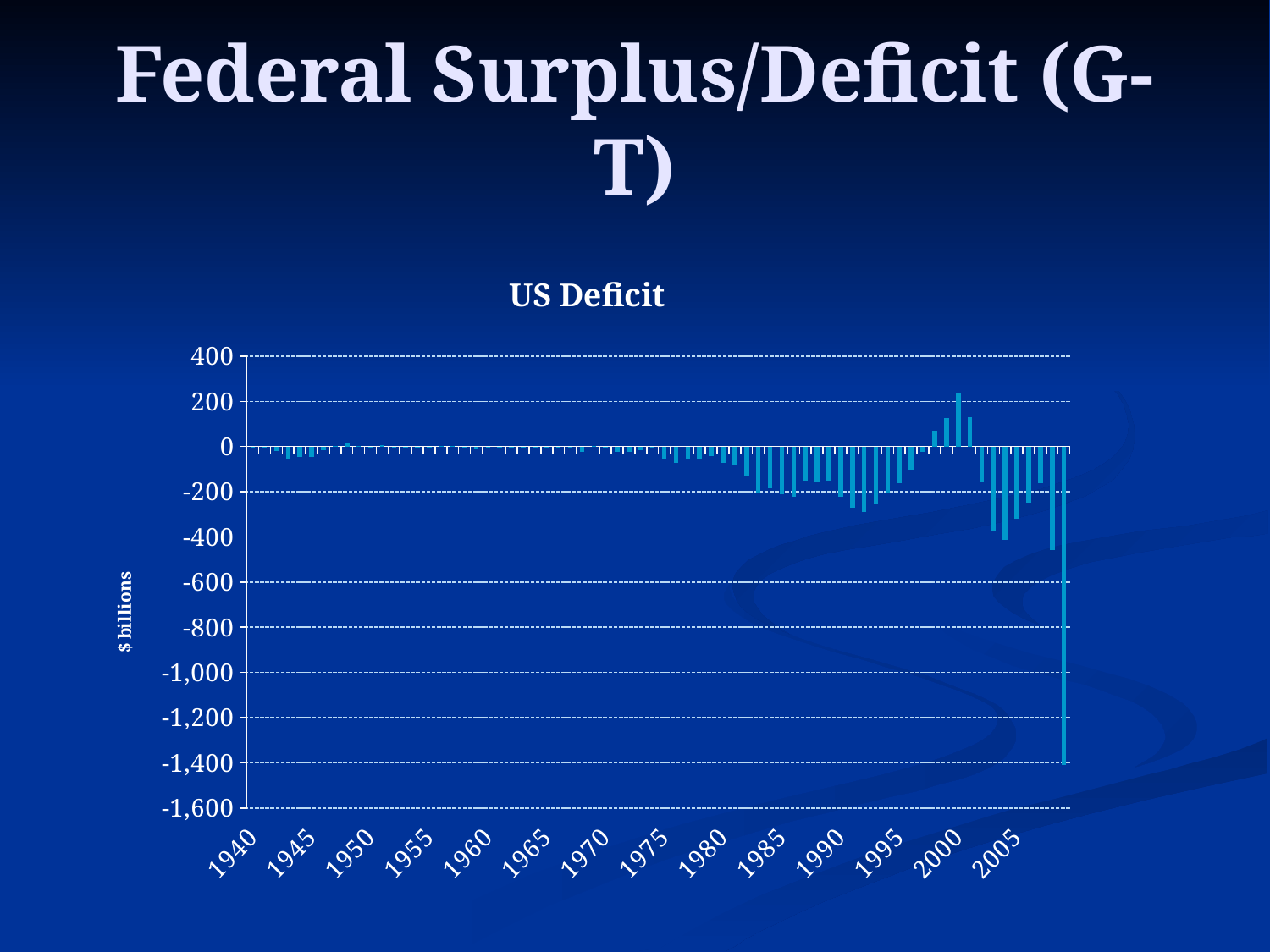
Is the value of the lowest bar in the US Deficit chart greater or less than -1,600? greater In the US Deficit chart, which is larger, the value for 1945 or the value for 2005? 1945 What kind of chart is the US Deficit chart? bar chart What is the label on the vertical axis of the US Deficit chart? $ billions Is the value of the lowest bar in the US Deficit chart greater or less than -1,200? less Is the value for 1960 in the US Deficit chart greater or less than -200? greater In the US Deficit chart, do the values rise or fall between 1995 and 2000? rise What is the title of the chart on the slide? US Deficit In the US Deficit chart, which is larger, the value for 1985 or the value for 2000? 2000